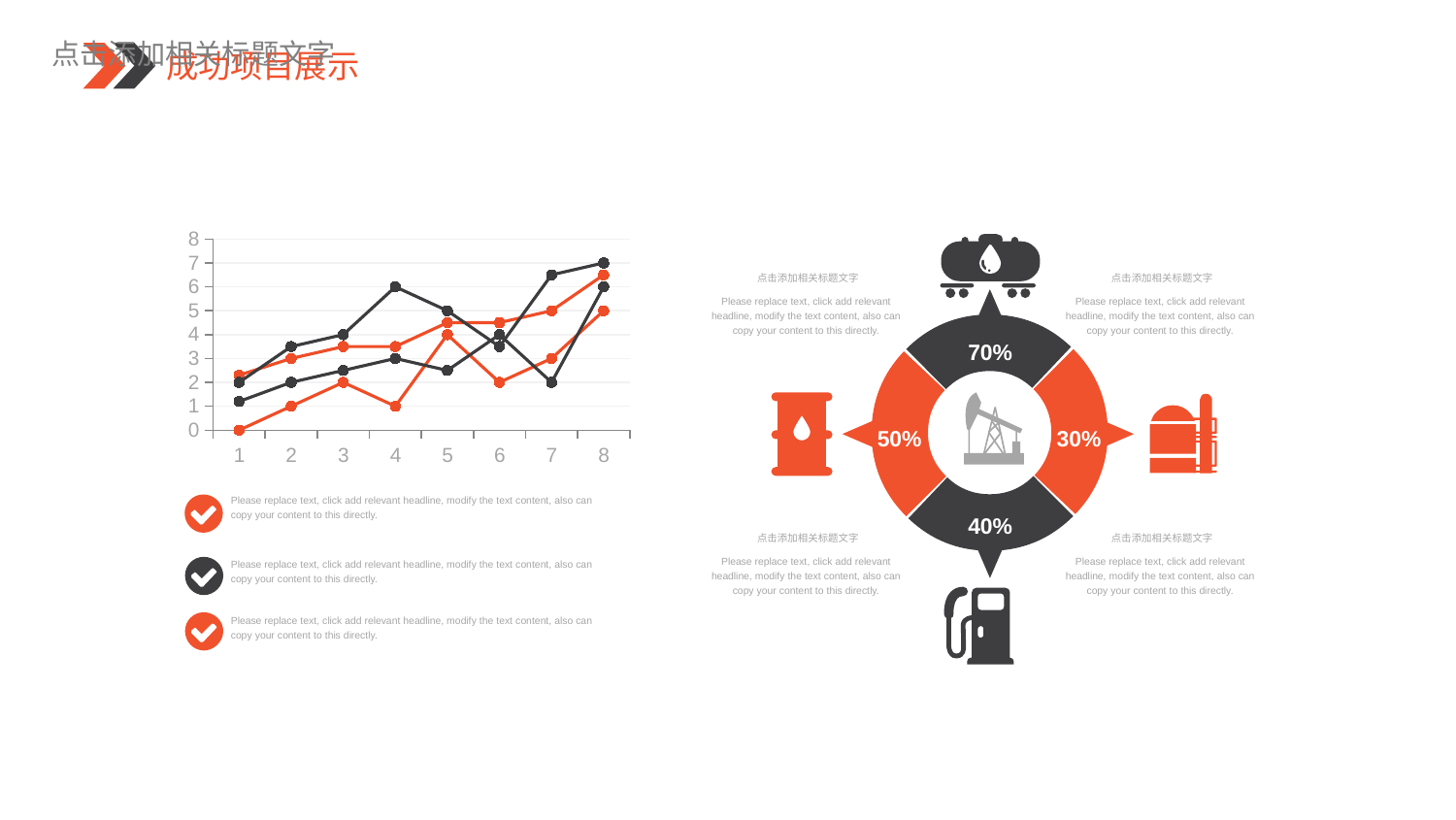
What type of chart is shown on the left of the slide? line chart In the line chart on the left, how many points are labelled along the x axis? 8 In the line chart on the left, how many lines are plotted? 4 In the line chart on the left, what is the highest value reached by any line at x = 8? 7 In the circular diagram on the right, what percentage is shown in the left segment? 50% In the line chart on the left, what is the lowest value of any line at x = 1? 0 In the circular diagram on the right, which percentage is the largest? 70% In the line chart on the left, is the highest line's value at x = 4 greater or less than 5? greater In the line chart on the left, is the lowest line's value at x = 6 greater or less than 3? less In the line chart on the left, what is the highest value shown on the y axis? 8 In the line chart on the left, which two colours are used for the lines? dark grey and orange In the line chart on the left, do the lines generally rise or fall from x = 1 to x = 8? rise